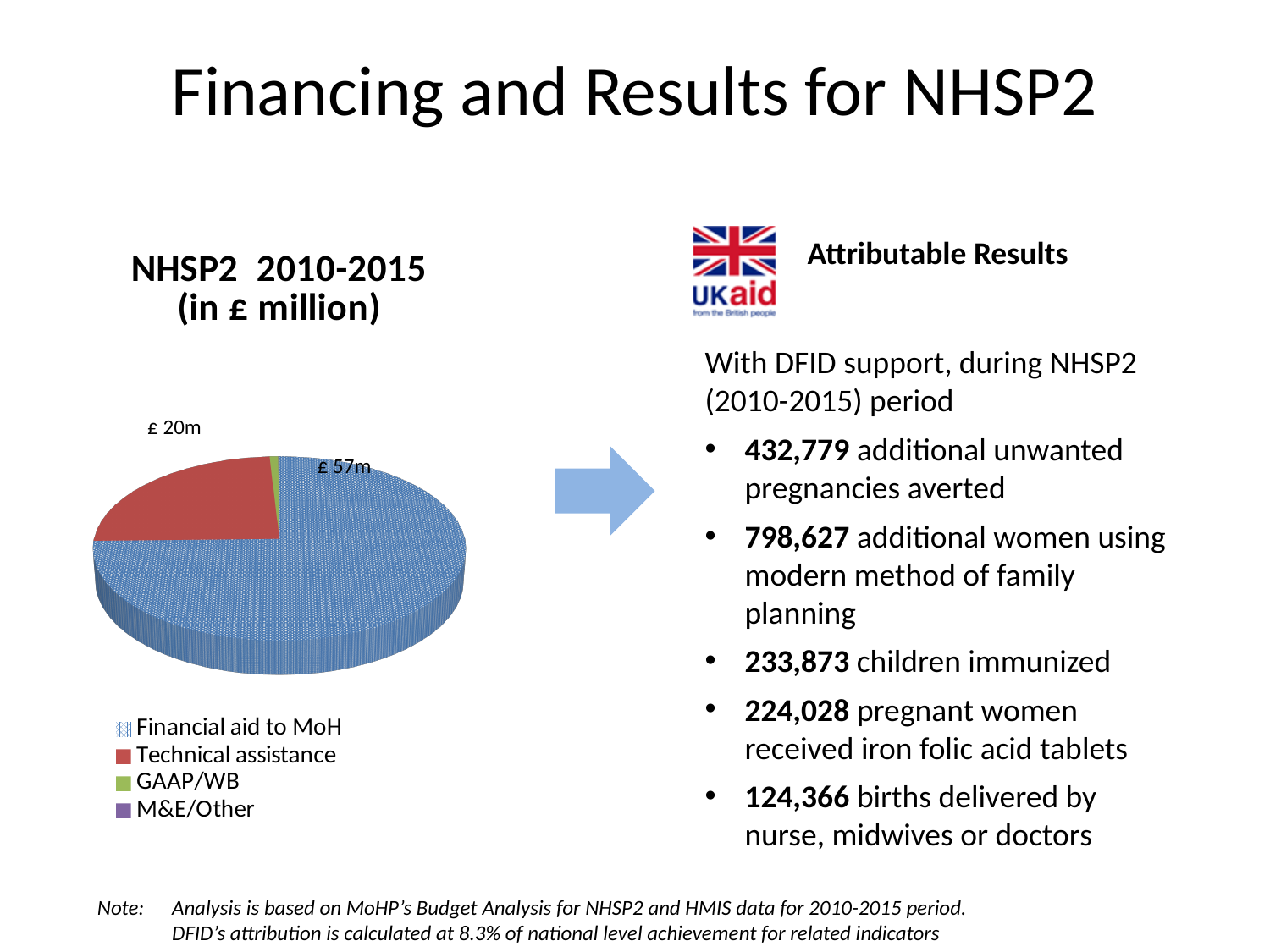
What kind of chart is shown on the slide? pie chart Which category is shown in red in the pie chart? Technical assistance How many categories does the pie chart's legend list? 4 What is the difference between the Financial aid to MoH value and the Technical assistance value? £ 37m Which is larger, Technical assistance or GAAP/WB? Technical assistance What is the value for Financial aid to MoH in the pie chart? £ 57m What is the value for Technical assistance in the pie chart? £ 20m Which is larger, Financial aid to MoH or Technical assistance? Financial aid to MoH What is the title of the pie chart? NHSP2 2010-2015 (in £ million) Which category has the largest slice in the pie chart? Financial aid to MoH